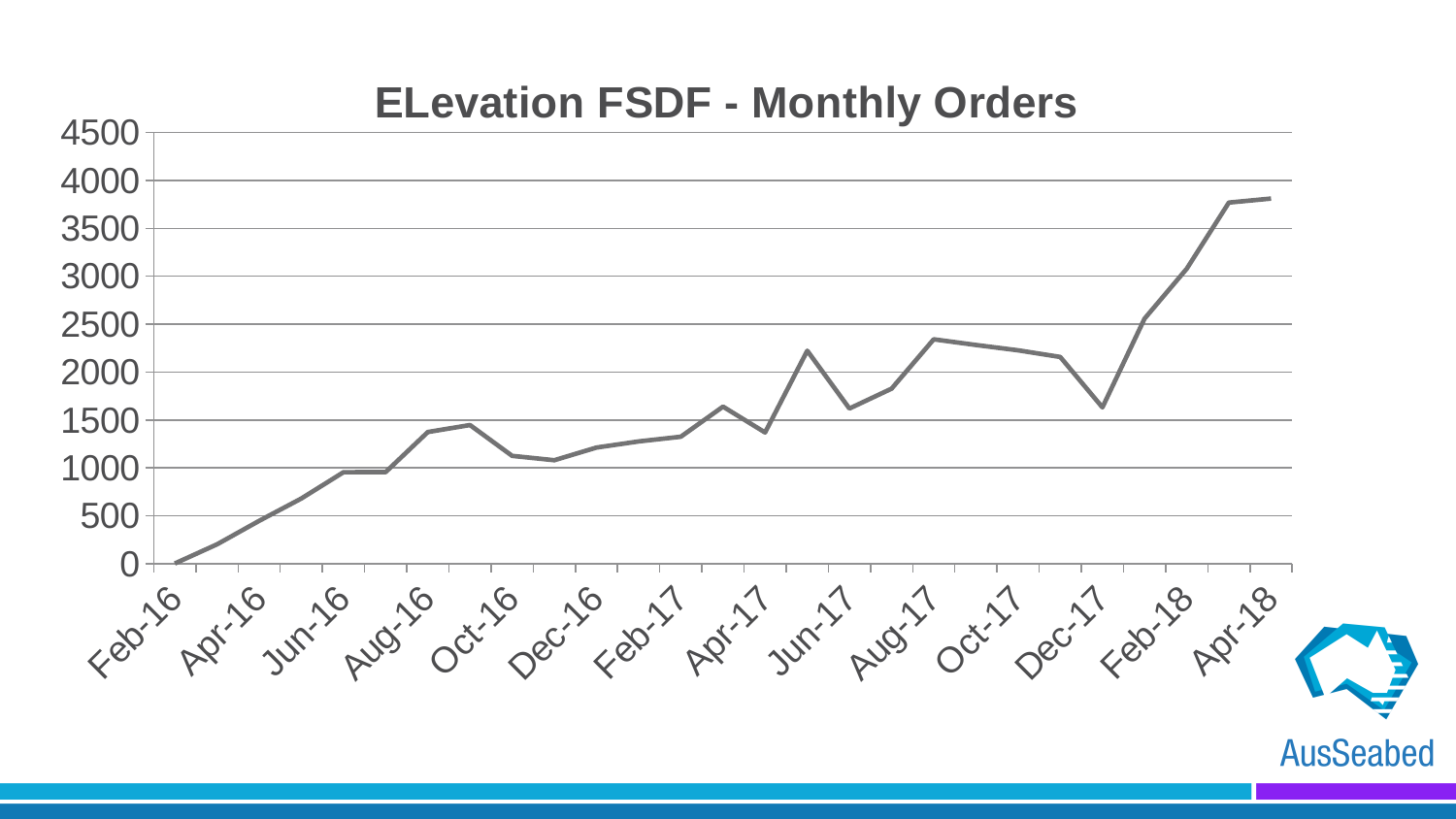
What kind of chart is shown on the slide? line chart What is the title of the chart? ELevation FSDF - Monthly Orders Which labelled month has the highest value? Apr-18 How many month labels are shown on the x axis? 14 Overall, do the values rise or fall from Feb-16 to Apr-18? rise Which labelled month has the lowest value? Feb-16 Is the value for Aug-17 greater or less than 2000? greater Which is larger, the value for Jun-17 or the value for Apr-17? Jun-17 Is the value for Dec-17 greater or less than 1500? greater Is the value for Apr-18 greater or less than 3500? greater